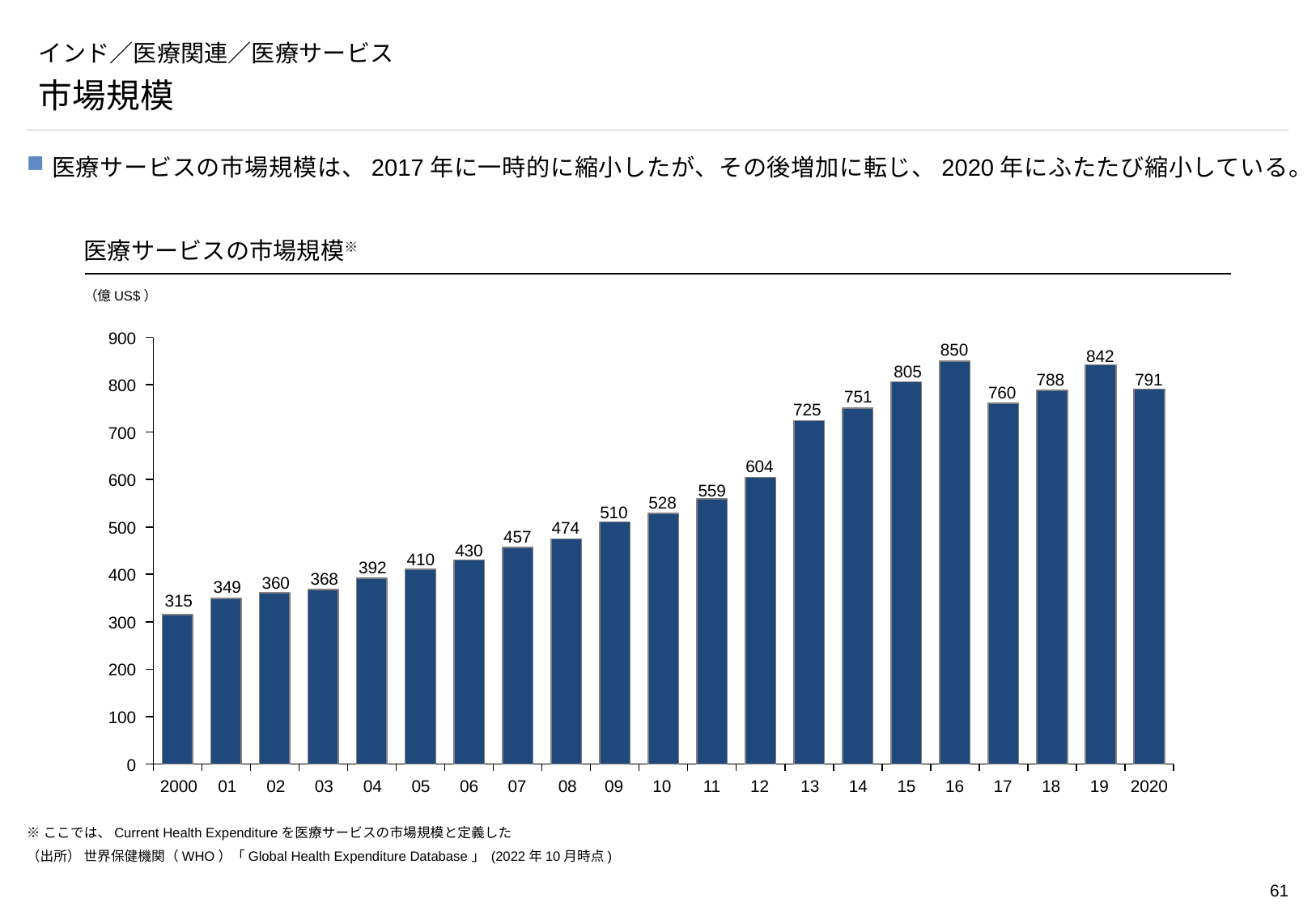
What is the difference between the values for 2016 and 2017? 90 What is the value for 2016? 850 What is the value for 2020? 791 Which is larger, the value for 2019 or the value for 2020? 2019 How many years are shown on the x axis? 21 What is the value for 2000? 315 Which year has the highest value? 2016 What unit is shown for the values on the chart? 億US$ Which year has the lowest value? 2000 What kind of chart is this? bar chart Do the values rise or fall from 2000 to 2016? rise Is the value for 2012 greater or less than 600? greater